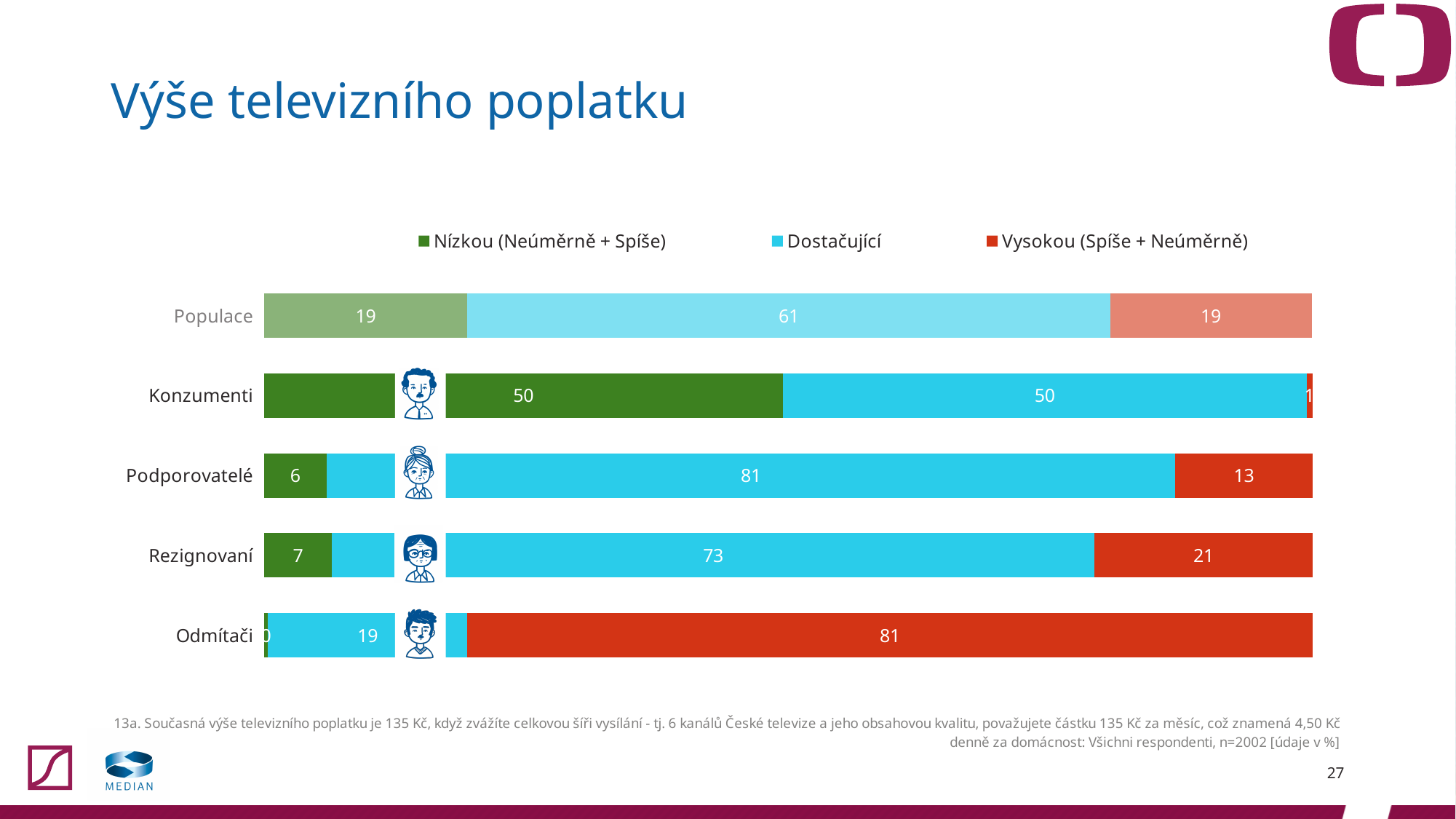
What is the difference between the Vysokou (Spíše + Neúměrně) values for Rezignovaní and Podporovatelé? 8 What is the value of Vysokou (Spíše + Neúměrně) for Odmítači? 81 Which is larger: the Nízkou (Neúměrně + Spíše) value for Rezignovaní or for Podporovatelé? Rezignovaní Which category has the highest value for Dostačující? Podporovatelé What is the title of the chart slide? Výše televizního poplatku What is the value of Vysokou (Spíše + Neúměrně) for Rezignovaní? 21 What is the value of Nízkou (Neúměrně + Spíše) for Konzumenti? 50 Which category has the lowest value for Dostačující? Odmítači What is the value of Dostačující for Populace? 61 What type of chart is shown on the slide? stacked bar chart How many categories are shown on the chart? 5 How many series does the legend list? 3